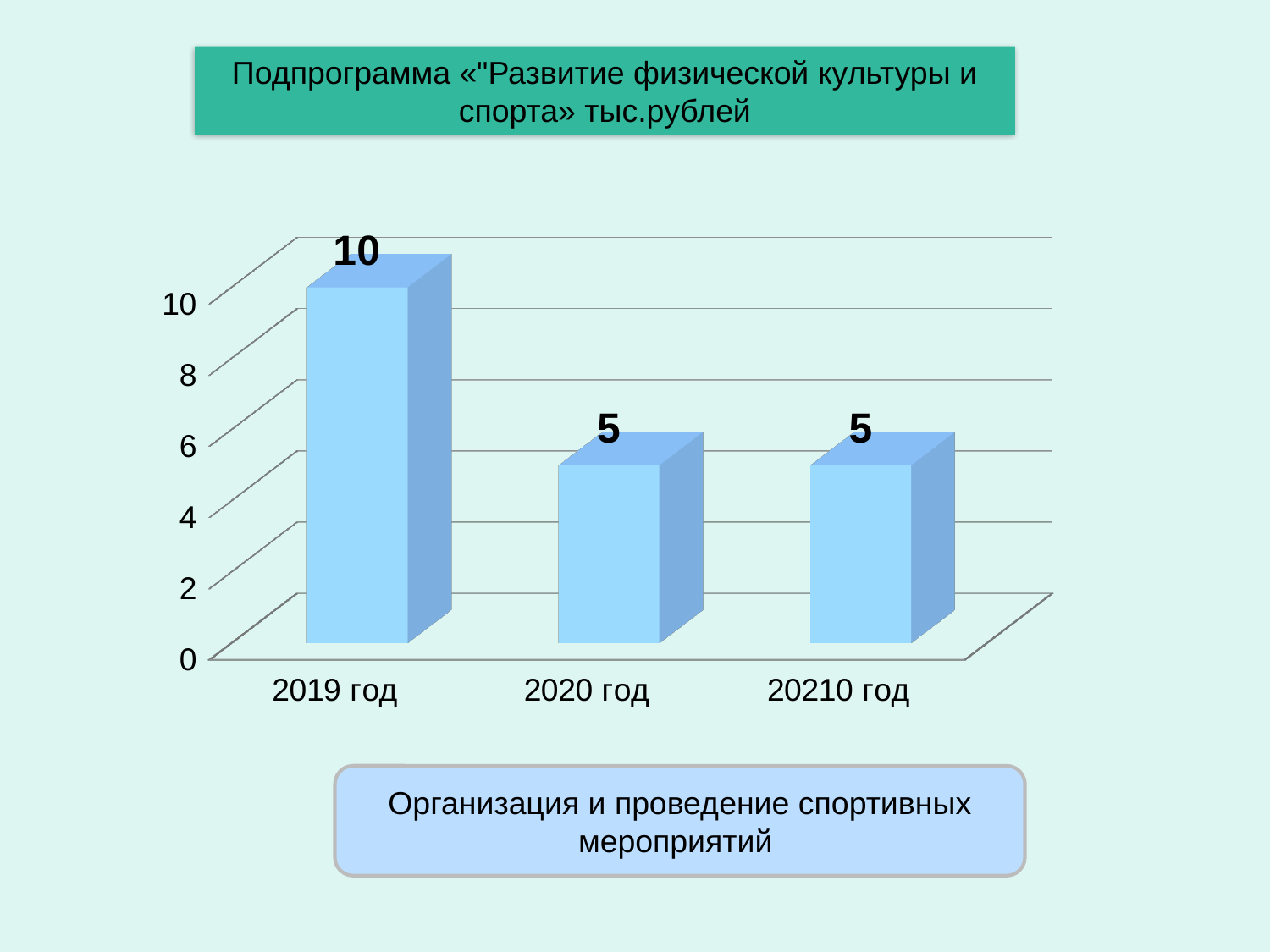
Is the value for 2020 год greater or less than 8? less Which year has the highest value? 2019 год What is the text in the box below the chart? Организация и проведение спортивных мероприятий What kind of chart is shown on the slide? bar chart Do the values rise or fall from 2019 год to 2020 год? fall What is the difference between the values for 2019 год and 2020 год? 5 What is the value for 2020 год? 5 What is the value for 2019 год? 10 Which is larger, the value for 2019 год or the value for 20210 год? 2019 год What is the value for 20210 год? 5 How many categories are shown on the x axis? 3 What is the highest tick value shown on the vertical axis? 10